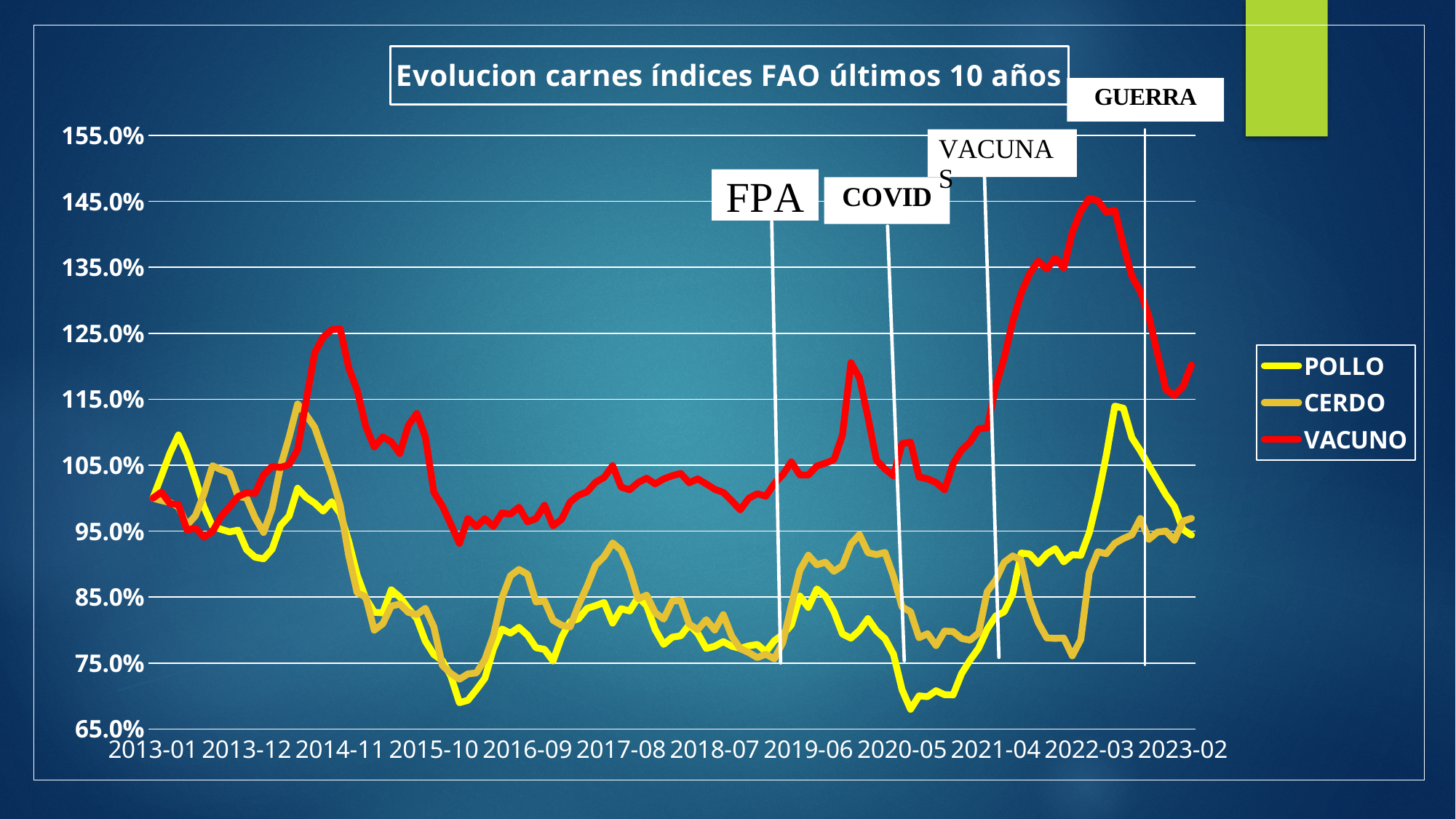
Which series has the lowest value at 2020-05? POLLO What is the title of the chart? Evolucion carnes índices FAO últimos 10 años What kind of chart is shown on the slide? line chart Is the peak value of VACUNO around 2022 greater or less than 135.0%? greater Does the VACUNO series rise or fall between 2021-04 and 2022-03? rise Is the lowest value of POLLO around 2020-05 greater or less than 75.0%? less How many series does the legend list? 3 Is the value of VACUNO at 2019-06 greater or less than 95.0%? greater How many date labels are shown on the x axis? 12 Which colour is used for the VACUNO series? red Which series has the highest value at 2022-03? VACUNO Which series reaches the highest value on the chart? VACUNO